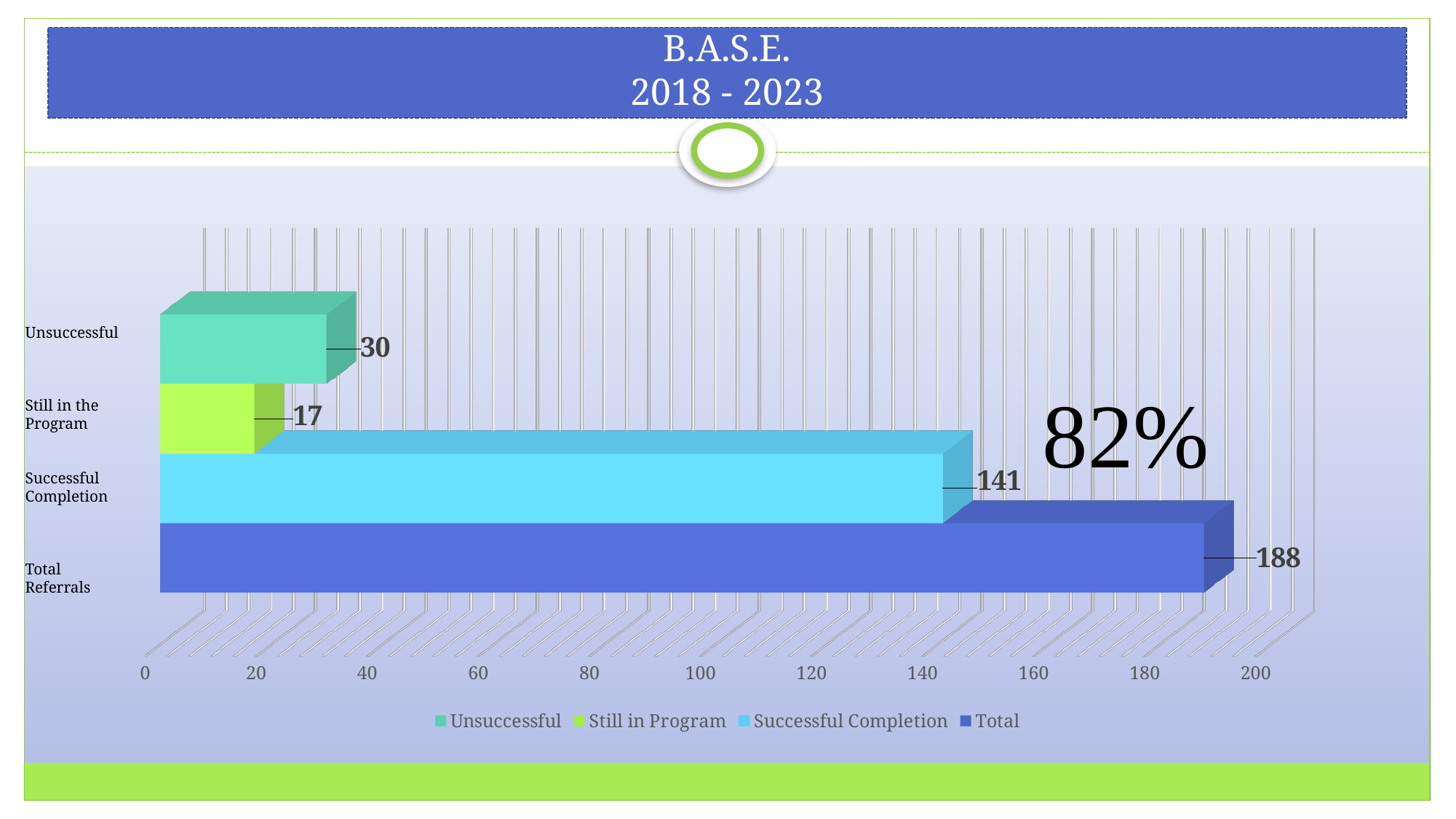
Which category has the lowest value? Still in the Program What is the value for Still in the Program? 17 How many entries does the legend list? 4 What is the value for Unsuccessful? 30 Which category has the highest value? Total Referrals What kind of chart is shown on the slide? Bar chart How many categories are shown in the chart? 4 What is the difference between Unsuccessful and Still in the Program? 13 Which is larger, Unsuccessful or Still in the Program? Unsuccessful What is the value for Total Referrals? 188 What is the value for Successful Completion? 141 What is the difference between Total Referrals and Successful Completion? 47